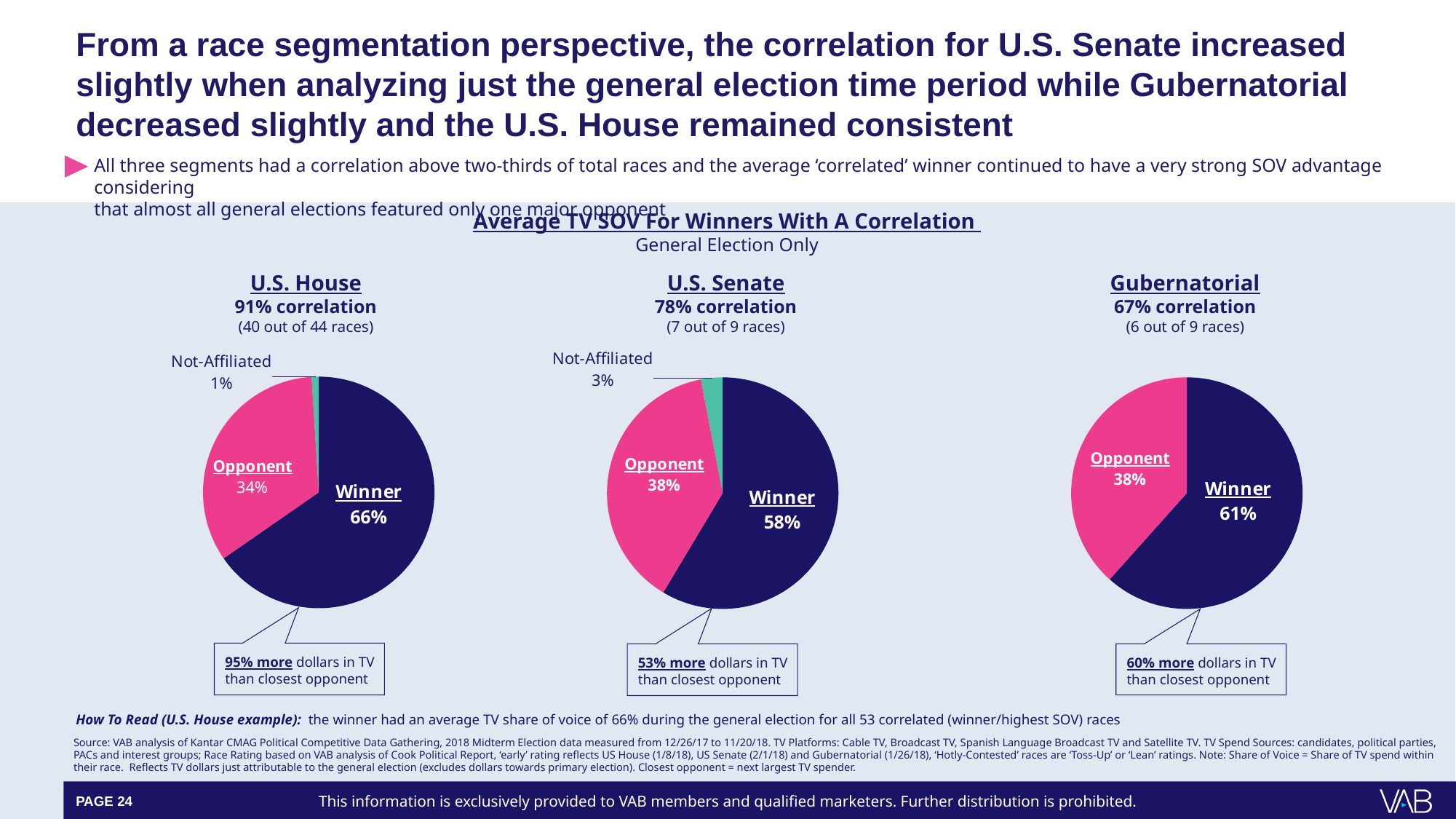
In the Gubernatorial pie chart, what is the value for Winner? 61% Is the Winner value larger in the U.S. House pie chart or the U.S. Senate pie chart? U.S. House What kind of chart is used for the U.S. House data? Pie chart In the U.S. House pie chart, what is the value for Winner? 66% In the Gubernatorial pie chart, which slice is the largest? Winner How many slices does the U.S. Senate pie chart have? 3 In the U.S. Senate pie chart, what is the difference between the Winner and Opponent values? 20% How many pie charts are shown on the slide? 3 In the U.S. House pie chart, which slice is the smallest? Not-Affiliated In the U.S. Senate pie chart, what is the value for Opponent? 38% In the U.S. House pie chart, what is the difference between the Winner and Opponent values? 32% In the U.S. Senate pie chart, what is the value for Not-Affiliated? 3%